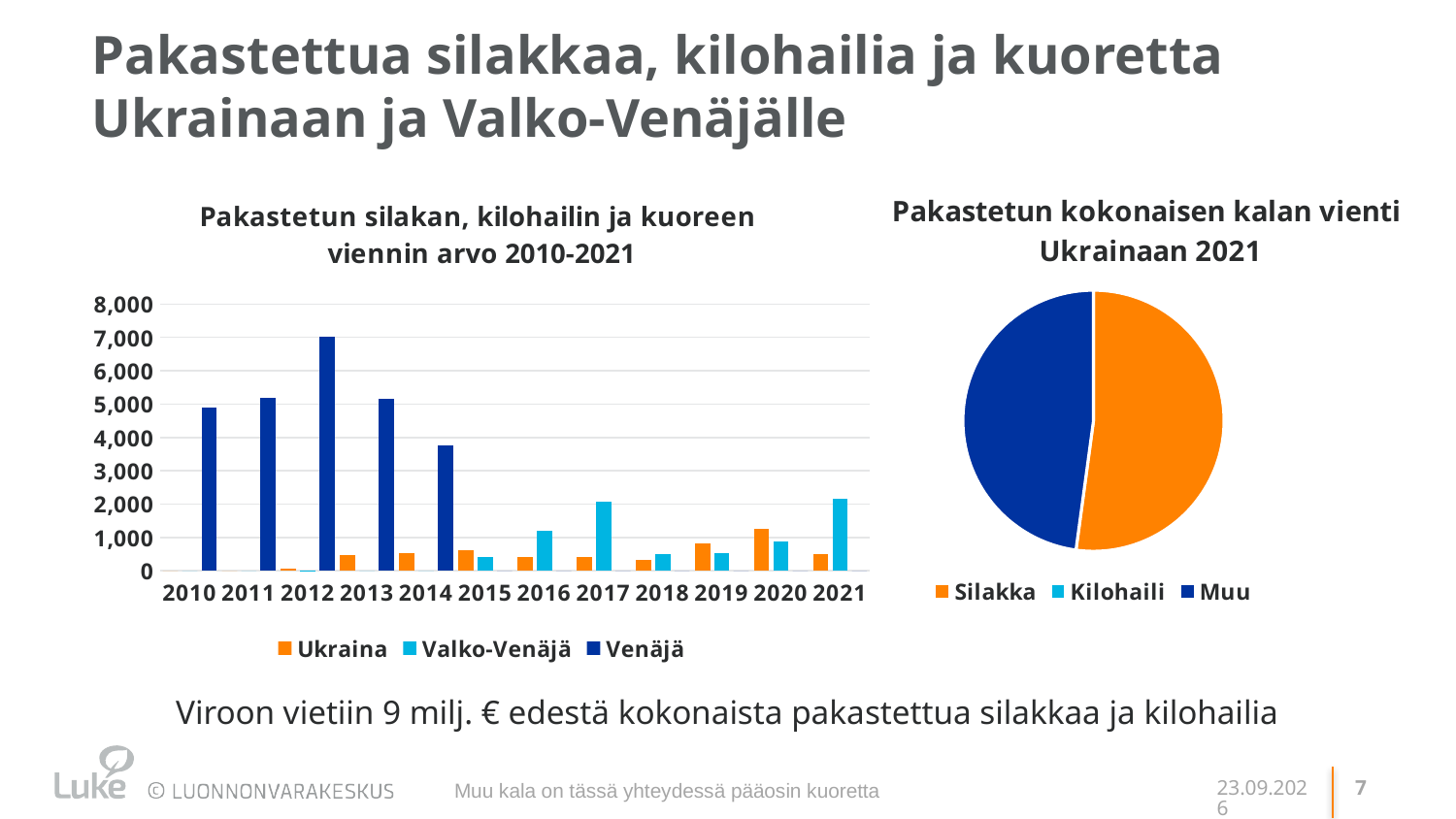
What kind of chart is 'Pakastetun silakan, kilohailin ja kuoreen viennin arvo 2010-2021'? Bar chart In the bar chart 'Pakastetun silakan, kilohailin ja kuoreen viennin arvo 2010-2021', do the Venäjä values rise or fall from 2012 to 2014? fall In the bar chart 'Pakastetun silakan, kilohailin ja kuoreen viennin arvo 2010-2021', how many years are shown on the x axis? 12 What kind of chart is 'Pakastetun kokonaisen kalan vienti Ukrainaan 2021'? Pie chart In the bar chart 'Pakastetun silakan, kilohailin ja kuoreen viennin arvo 2010-2021', which is larger in 2017: Ukraina or Valko-Venäjä? Valko-Venäjä In the bar chart 'Pakastetun silakan, kilohailin ja kuoreen viennin arvo 2010-2021', is the Venäjä value for 2014 greater or less than 4,000? less In the bar chart 'Pakastetun silakan, kilohailin ja kuoreen viennin arvo 2010-2021', in which year is the Venäjä value highest? 2012 In the bar chart 'Pakastetun silakan, kilohailin ja kuoreen viennin arvo 2010-2021', how many series does the legend list? 3 In the bar chart 'Pakastetun silakan, kilohailin ja kuoreen viennin arvo 2010-2021', in which year is the Ukraina value highest? 2020 In the bar chart 'Pakastetun silakan, kilohailin ja kuoreen viennin arvo 2010-2021', is the Venäjä value for 2012 greater or less than 6,000? greater In the bar chart 'Pakastetun silakan, kilohailin ja kuoreen viennin arvo 2010-2021', is the Ukraina value for 2020 greater or less than 1,000? greater In the pie chart 'Pakastetun kokonaisen kalan vienti Ukrainaan 2021', what entries does the legend list? Silakka, Kilohaili, Muu